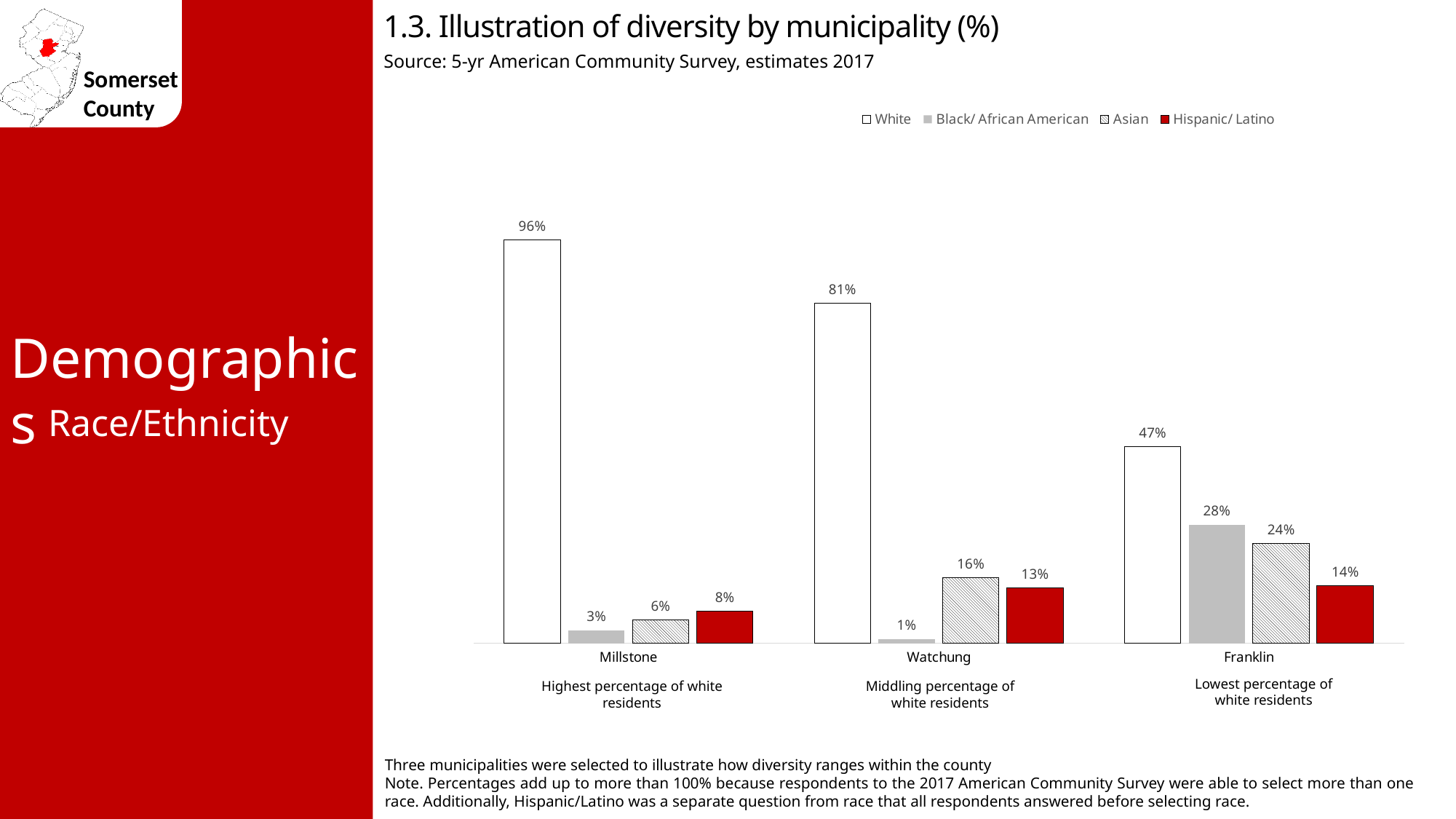
What kind of chart is shown? Bar chart What is the White percentage for Millstone? 96% What is the Hispanic/ Latino percentage for Franklin? 14% Which municipality has the highest White percentage? Millstone Which series is shown in red? Hispanic/ Latino Which municipality has the lowest Black/ African American percentage? Watchung What is the Asian percentage for Watchung? 16% What is the difference between the White percentages for Millstone and Franklin? 49% How many municipalities are shown on the x axis? 3 What is the Black/ African American percentage for Watchung? 1% Which is larger: the Asian percentage for Franklin or the Hispanic/ Latino percentage for Franklin? Asian percentage for Franklin How many series does the legend list? 4